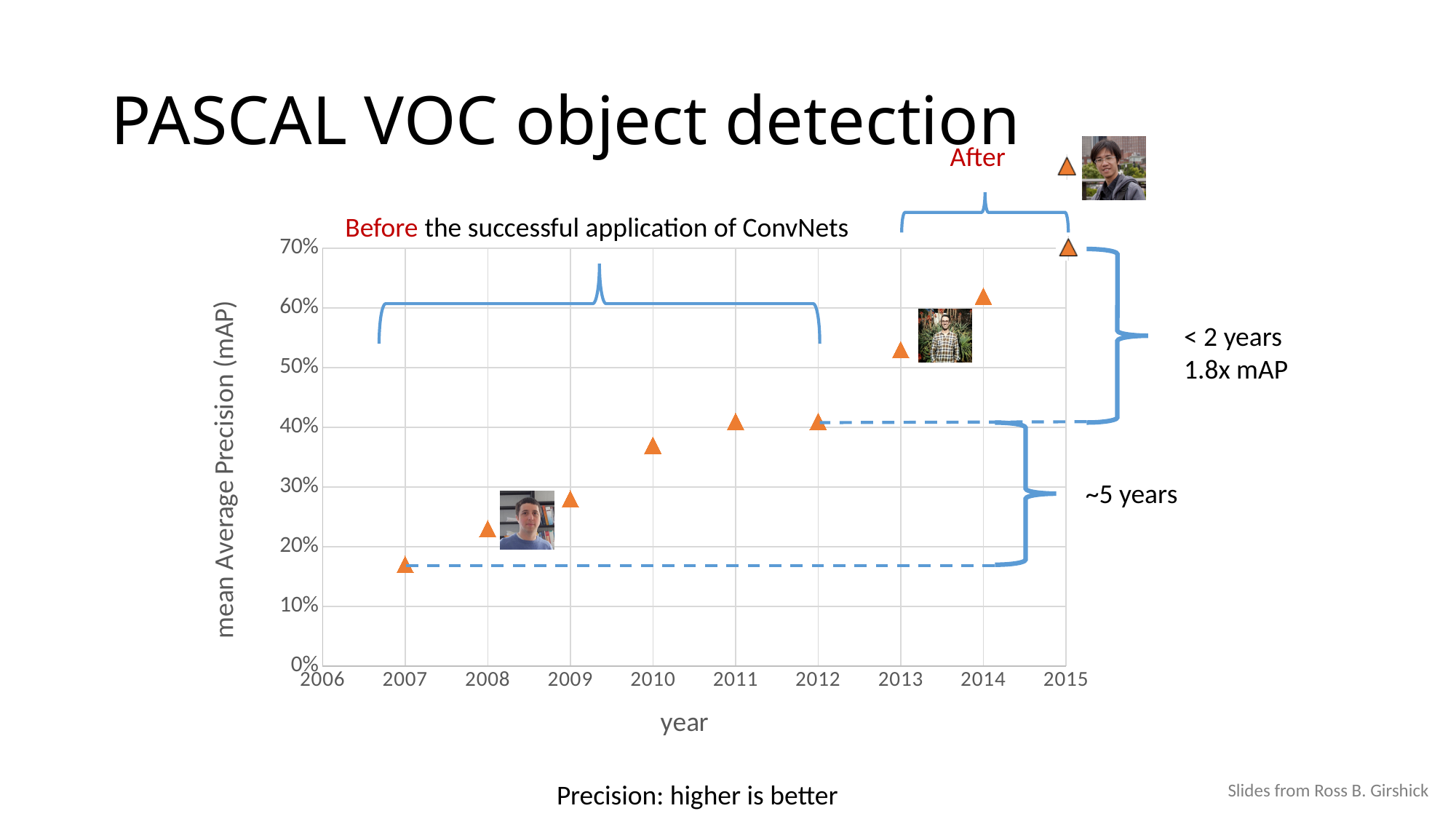
Is the value for 2013 greater or less than 50%? greater Is the value for 2014 greater or less than 60%? greater Which year has a higher mean Average Precision, 2010 or 2014? 2014 Is the value for 2010 greater or less than 40%? less Do the mean Average Precision values generally rise or fall from 2007 to 2015? rise What kind of chart is shown on the slide? scatter plot What is the label of the y axis? mean Average Precision (mAP) How many data points are plotted on the chart? 9 Which year has the lowest mean Average Precision? 2007 Which year has the highest mean Average Precision? 2015